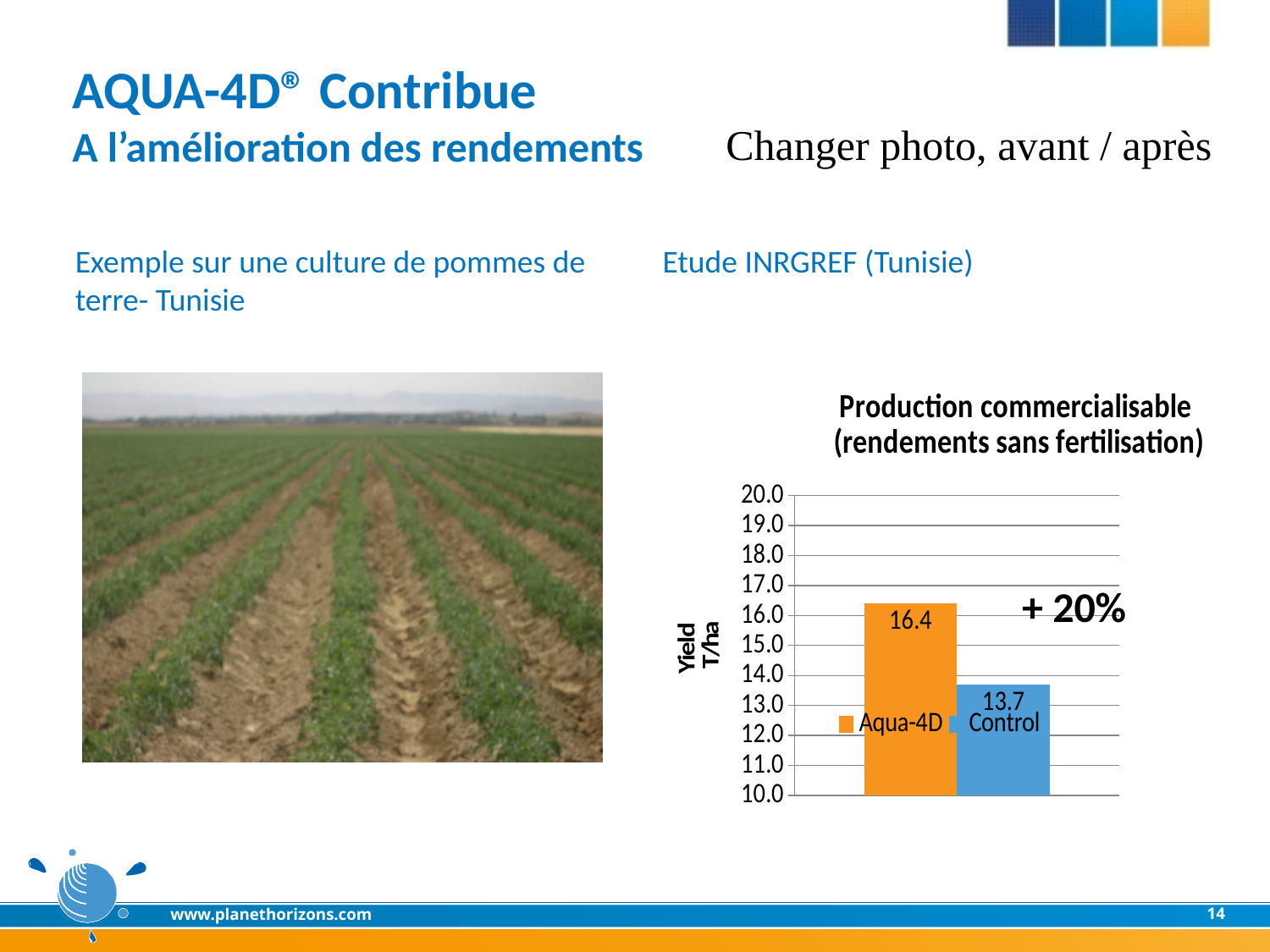
What is the value for Control in the chart? 13.7 What is the title of the chart? Production commercialisable (rendements sans fertilisation) How many series does the chart legend list? 2 What is the value for Aqua-4D in the chart? 16.4 What is the label of the vertical axis of the chart? Yield T/ha Is the value for Aqua-4D greater or less than 15.0? greater What is the difference between the Aqua-4D value and the Control value? 2.7 Which series has the highest value in the chart? Aqua-4D Which series has the lowest value in the chart? Control What kind of chart is shown on the slide? bar chart Which is larger, the value for Aqua-4D or the value for Control? Aqua-4D Is the value for Control greater or less than 14.0? less